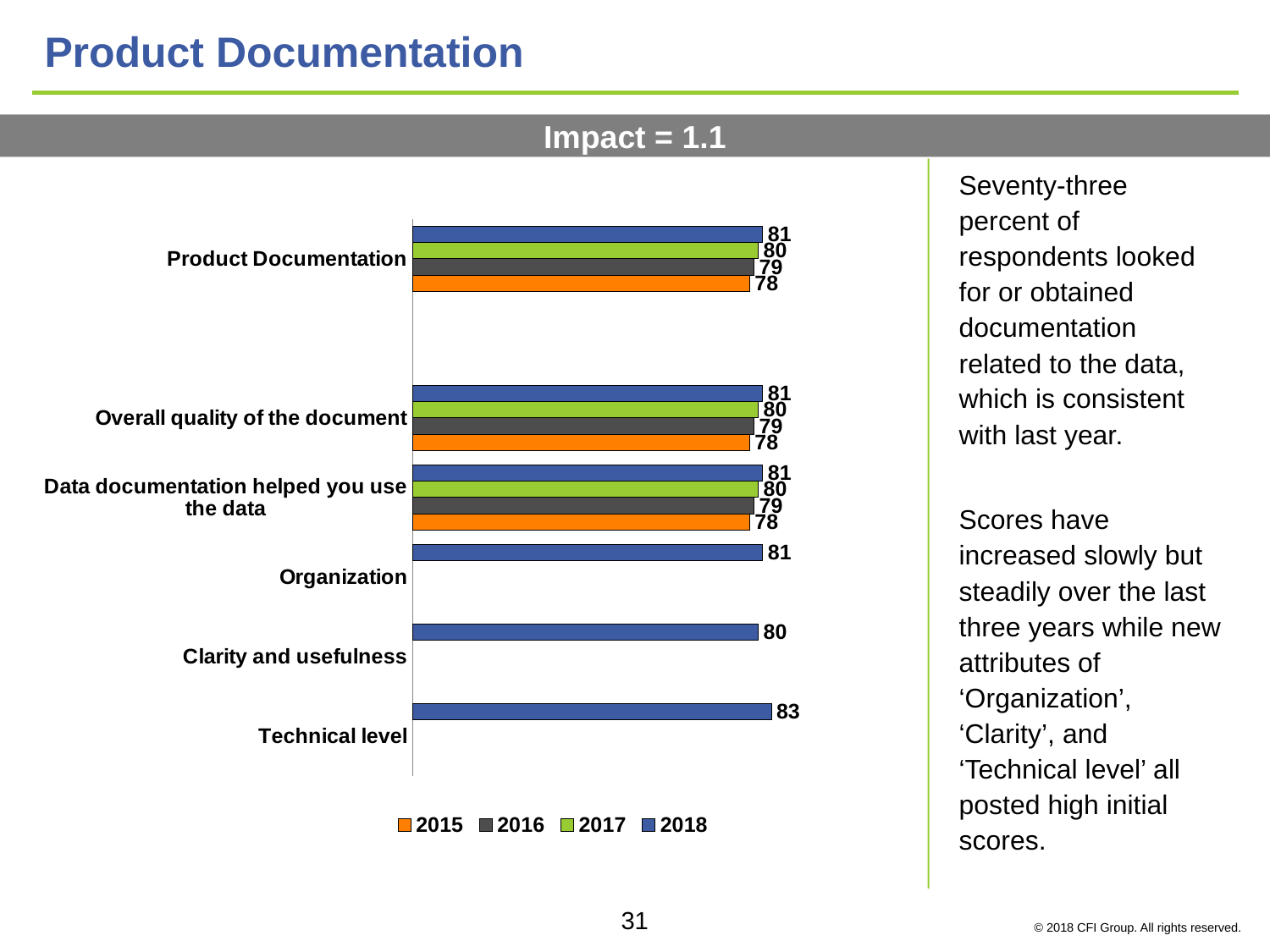
What is the difference between the 2018 and 2015 values for Data documentation helped you use the data? 3 Which category has the highest 2018 value? Technical level How many categories are shown on the chart? 6 Which is larger, the 2018 value for Technical level or the 2018 value for Organization? Technical level What kind of chart is shown on the slide? Bar chart Do the values for Product Documentation rise or fall from 2015 to 2018? Rise Which category has the lowest 2018 value? Clarity and usefulness What is the 2018 value for Technical level? 83 What is the 2018 value for Clarity and usefulness? 80 What is the 2017 value for Overall quality of the document? 80 How many series does the legend list? 4 What is the 2015 value for Product Documentation? 78